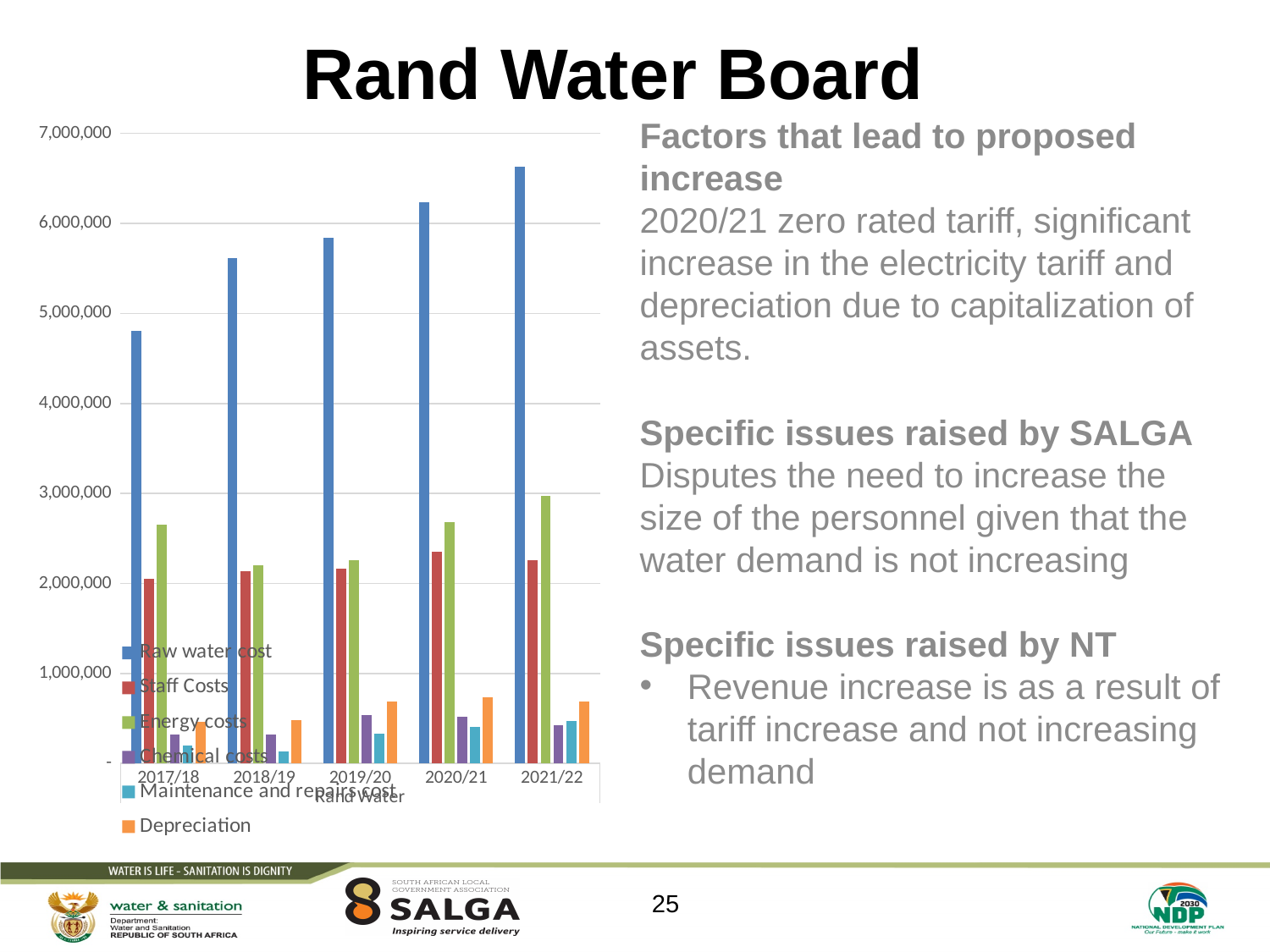
Does the Raw water cost rise or fall from 2017/18 to 2021/22? Rise Is the Raw water cost for 2021/22 greater or less than 6,000,000? greater In which year is the Raw water cost bar the lowest? 2017/18 What kind of chart is shown on the slide? Bar chart In 2017/18, which is larger: Energy costs or Staff Costs? Energy costs Which series has the tallest bar in 2020/21? Raw water cost What is the title shown below the x axis of the chart? Rand Water Is the Depreciation value for 2017/18 greater or less than 1,000,000? less Is the Raw water cost for 2017/18 greater or less than 5,000,000? less In which year is the Raw water cost bar the highest? 2021/22 How many financial years are shown on the x axis of the chart? 5 How many series does the chart legend list? 6